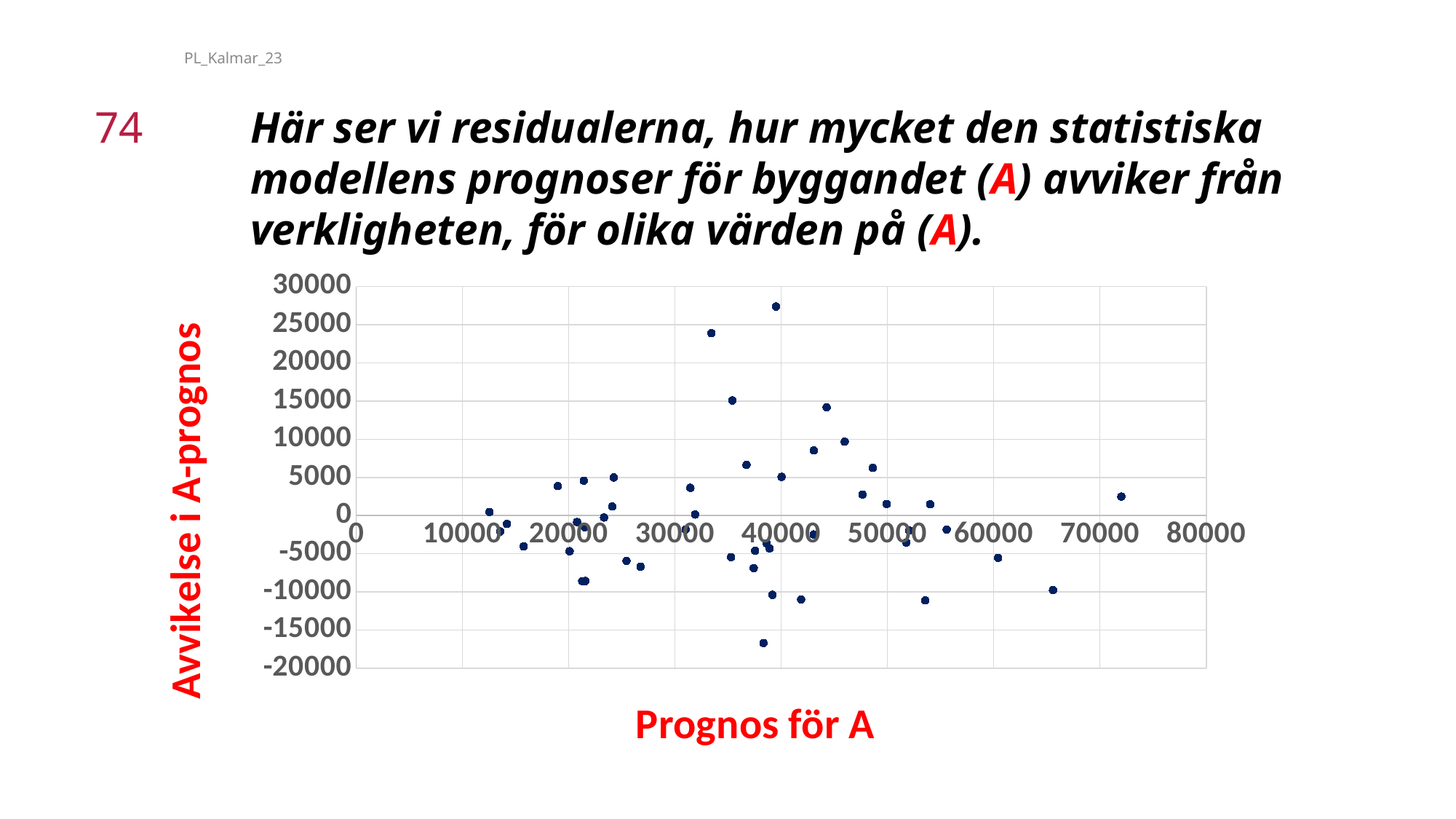
Is the y value of the lowest point in the chart greater or less than -15000? less What is the lowest tick value shown on the y axis? -20000 What is the title of the y axis of the chart? Avvikelse i A-prognos Is the x value of the leftmost point in the chart greater or less than 10000? greater Is the x value of the rightmost point in the chart greater or less than 70000? greater What is the title of the x axis of the chart? Prognos för A What is the highest tick value shown on the x axis? 80000 What is the highest tick value shown on the y axis? 30000 What kind of chart is shown on the slide? scatter plot